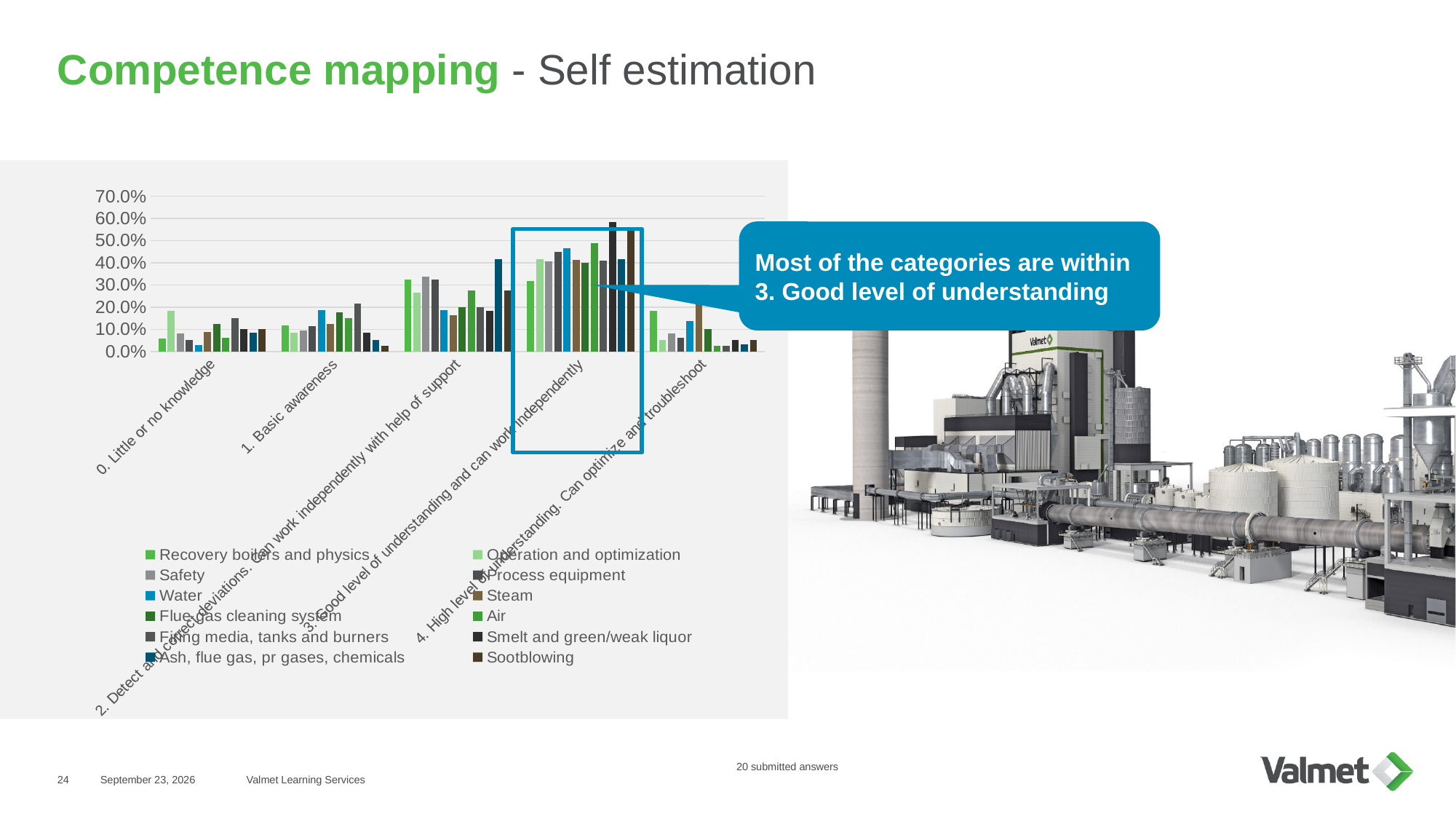
What is the highest value shown on the chart's y axis? 70.0% Is the value for Water in the category '1. Basic awareness' greater or less than 10%? greater Is the value for Recovery boilers and physics in the category '2. Detect and correct deviations. Can work independently with help of support' greater or less than 20%? greater Which x-axis category contains the tallest bar on the chart? 3. Good level of understanding and can work independently According to the callout on the chart, which level are most of the categories within? 3. Good level of understanding What kind of chart is shown on the slide? bar chart Is the value for Operation and optimization in the category '0. Little or no knowledge' greater or less than 10%? greater How many competence-level categories are shown along the x axis of the chart? 5 How many series does the chart's legend list? 12 In the category '3. Good level of understanding and can work independently', which is larger: Smelt and green/weak liquor or Recovery boilers and physics? Smelt and green/weak liquor